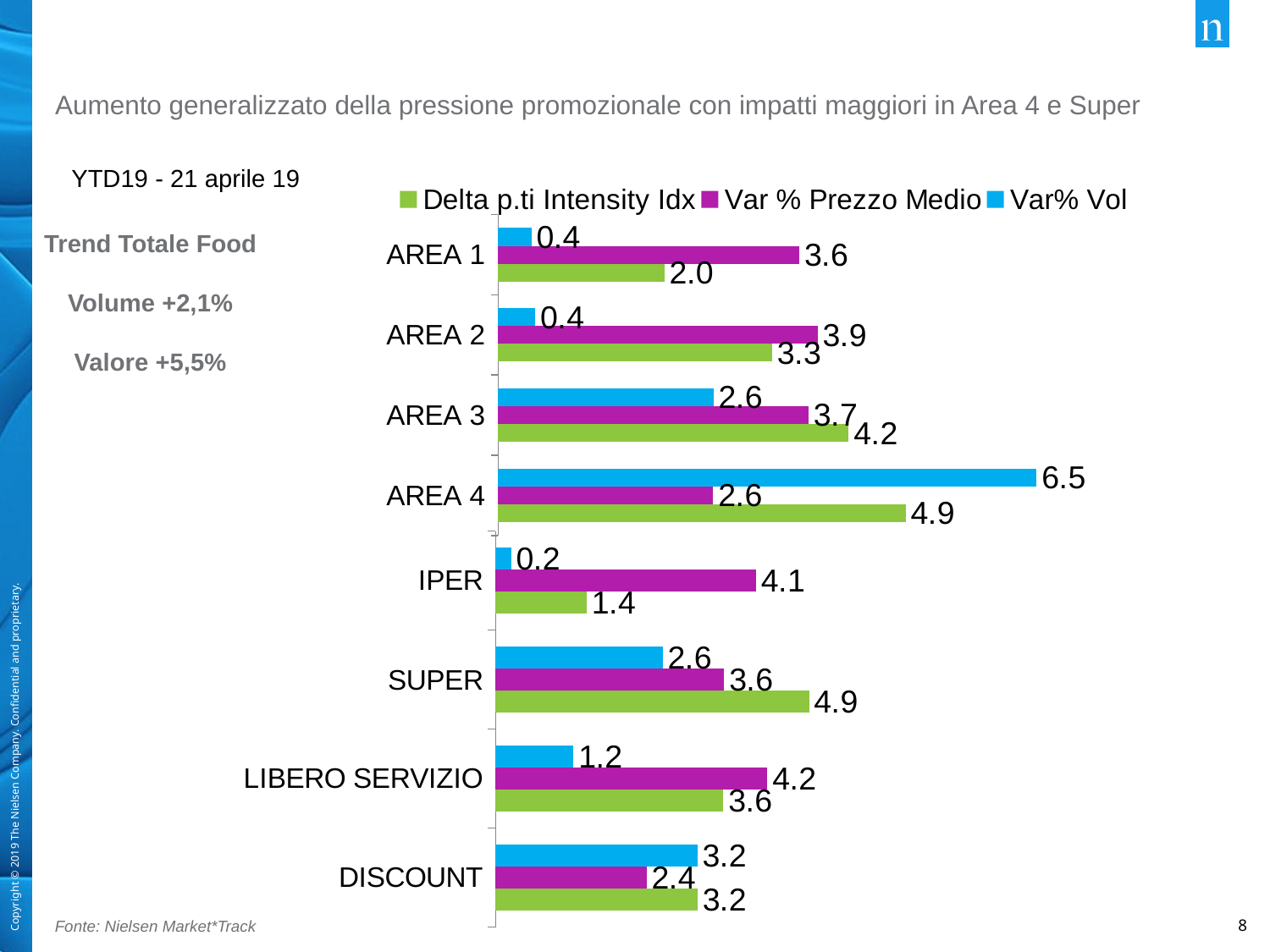
How many series does the legend list? 3 How many categories are shown on the chart? 8 Which series is shown in green in the legend? Delta p.ti Intensity Idx What is the Delta p.ti Intensity Idx value for LIBERO SERVIZIO? 3.6 What is the Var% Vol value for AREA 4? 6.5 Which is larger for SUPER: the Delta p.ti Intensity Idx value or the Var % Prezzo Medio value? Delta p.ti Intensity Idx What is the Var % Prezzo Medio value for IPER? 4.1 Which category has the lowest Var% Vol value? IPER Which category has the highest Var% Vol value? AREA 4 What kind of chart is shown on the slide? Bar chart What is the difference between the Var% Vol value for AREA 4 and the Var% Vol value for AREA 3? 3.9 Which category has the lowest Var % Prezzo Medio value? DISCOUNT